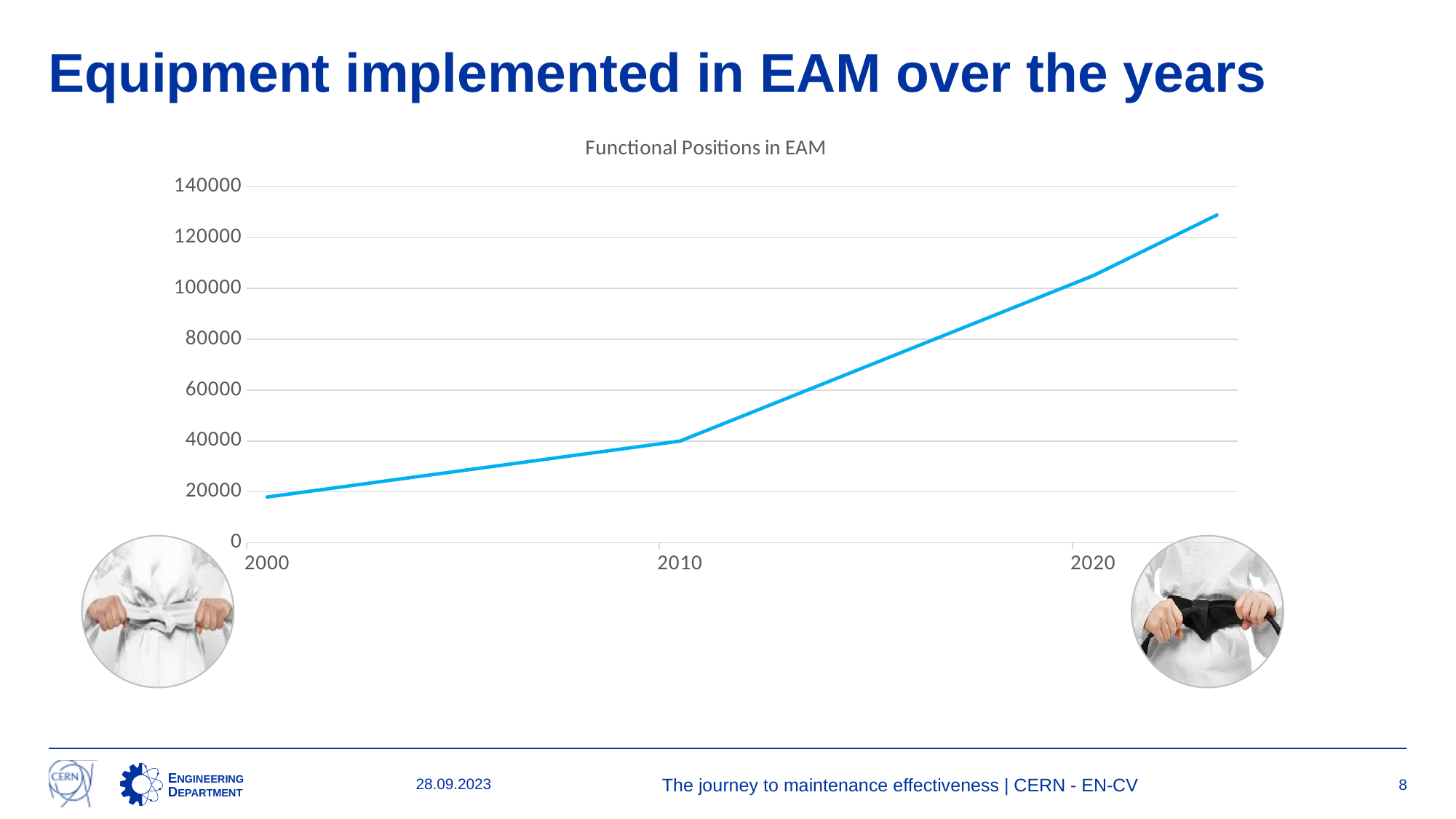
How many year labels are shown on the x axis? 3 Which year shown on the x axis has the highest value? 2020 What kind of chart is shown on the slide? line chart Is the value for 2000 greater or less than 40000? less Which is larger, the value for 2010 or the value for 2020? 2020 Is the value for 2020 greater or less than 80000? greater What is the title of the chart? Functional Positions in EAM Is the value at the right end of the line greater or less than 120000? greater Which year shown on the x axis has the lowest value? 2000 Do the values in the chart rise or fall from 2000 to 2020? rise